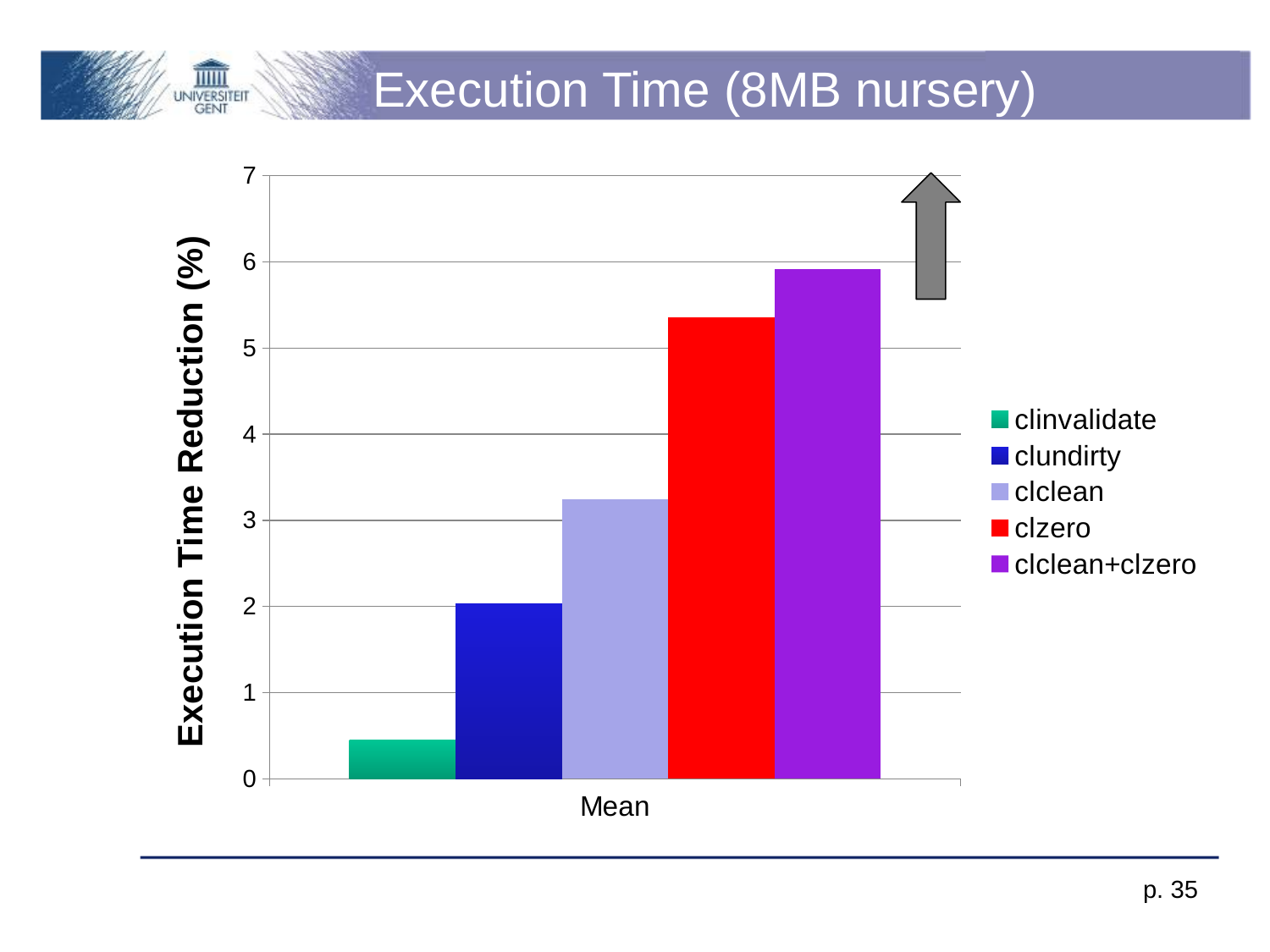
Which series has the lowest execution time reduction for Mean? clinvalidate Is the value for clzero greater or less than 5? greater What is the label of the y axis? Execution Time Reduction (%) How many series does the legend list? 5 How many categories are shown on the x axis? 1 Which is larger, the value for clzero or the value for clclean+clzero? clclean+clzero Is the value for clinvalidate greater or less than 1? less Which is larger, the value for clundirty or the value for clclean? clclean Which series has the highest execution time reduction for Mean? clclean+clzero What kind of chart is shown on the slide? bar chart Is the value for clclean greater or less than 3? greater